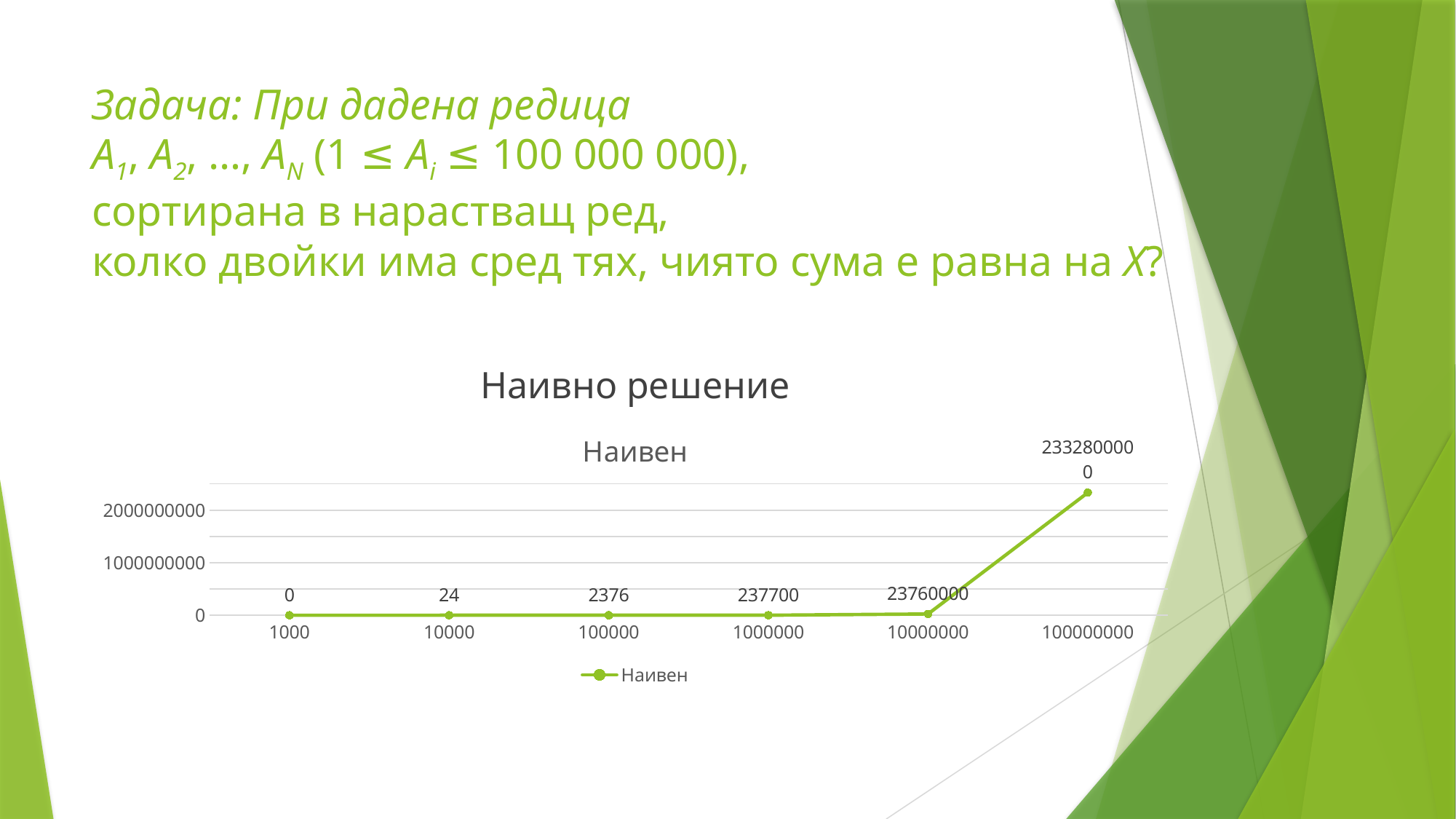
What kind of chart is shown on the slide? line chart What is the difference between the values for 1000000 and 100000? 235324 What is the value for 10000000 in the Наивен chart? 23760000 What is the value for 100000 in the Наивен chart? 2376 Is the value for 100000000 greater or less than 2000000000? greater Which x-axis category has the lowest value? 1000 What is the value for 1000 in the Наивен chart? 0 Which x-axis category has the highest value? 100000000 How many data points are plotted on the chart? 6 What is the value for 1000000 in the Наивен chart? 237700 What is the value for 10000 in the Наивен chart? 24 Do the values rise or fall as you move along the x axis? rise